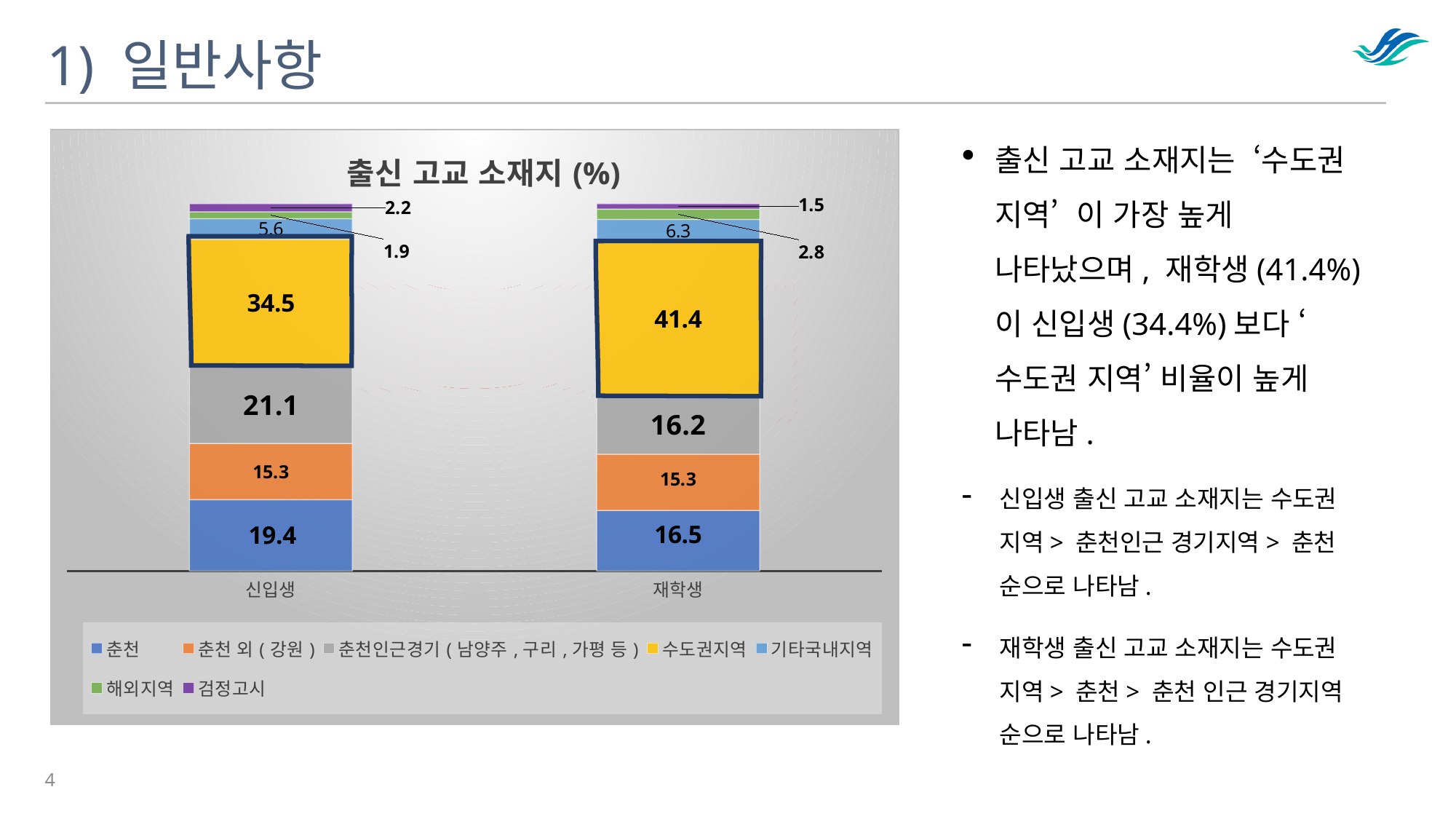
What is the value of 기타국내지역 for 신입생? 5.6 What type of chart is shown on the slide? Stacked bar chart What is the title of the chart? 출신 고교 소재지 (%) What is the value of 수도권지역 for 신입생? 34.5 What is the value of 수도권지역 for 재학생? 41.4 Which is larger, the 춘천인근경기 value for 신입생 or for 재학생? 신입생 How many series does the chart legend list? 7 How many categories are shown on the x axis of the chart? 2 Which series has the smallest value in the 재학생 bar? 검정고시 What is the difference between the 수도권지역 values for 재학생 and 신입생? 6.9 Which series has the largest value in the 신입생 bar? 수도권지역 What is the value of 춘천 for 재학생? 16.5